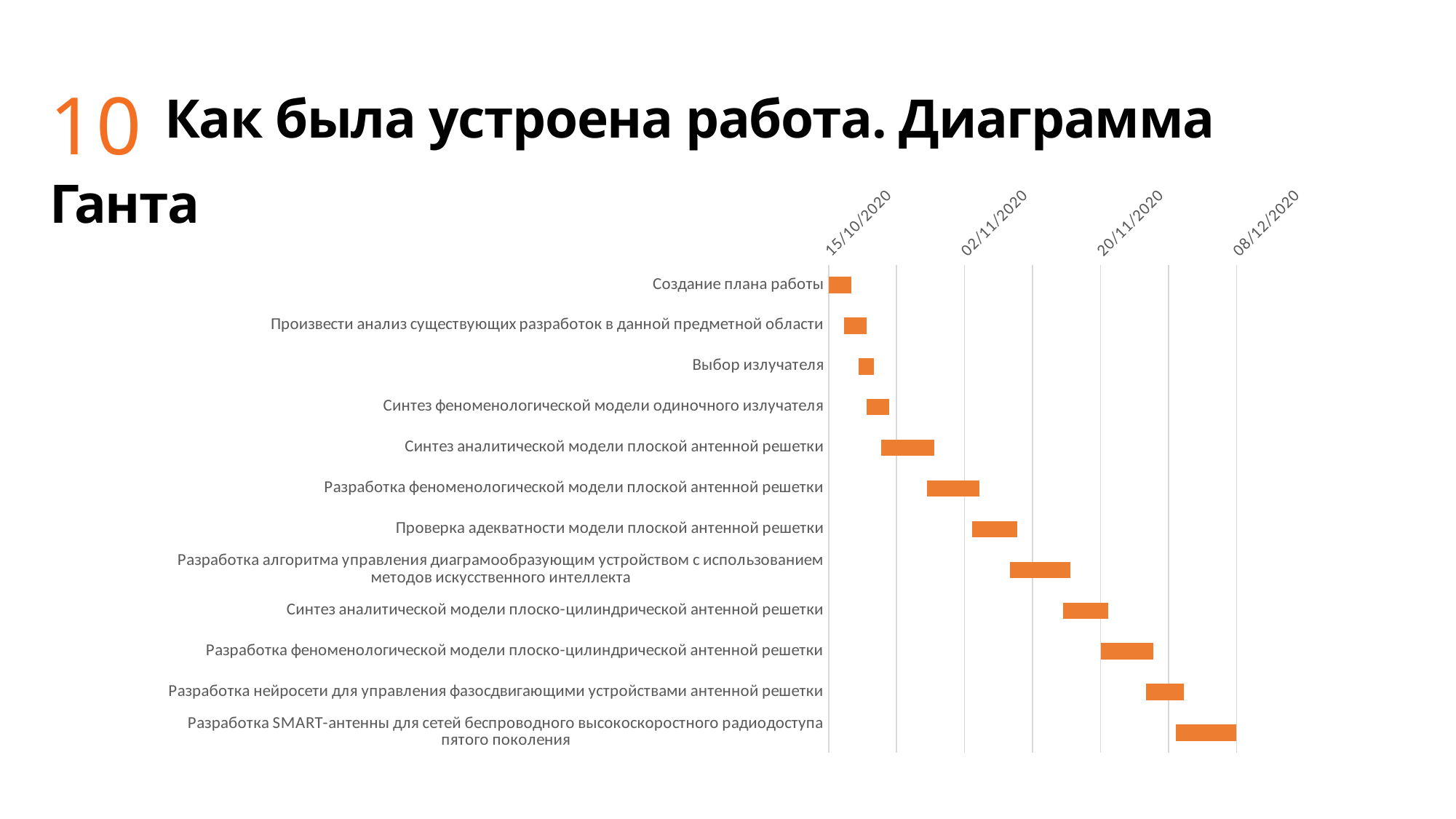
What kind of chart is shown on the slide? Bar chart (Gantt chart) How many date labels are shown on the horizontal axis? 4 Which task has the shortest bar in the Gantt chart? Выбор излучателя Which task's bar starts earliest on the timeline? Создание плана работы What is the earliest date label shown on the horizontal axis? 15/10/2020 Which task's bar ends latest on the timeline? Разработка SMART-антенны для сетей беспроводного высокоскоростного радиодоступа пятого поколения What is the latest date label shown on the horizontal axis? 08/12/2020 Which task is listed first (at the top) of the Gantt chart? Создание плана работы Does the bar for 'Разработка нейросети для управления фазосдвигающими устройствами антенной решетки' start before or after 20/11/2020? after Does the bar for 'Проверка адекватности модели плоской антенной решетки' start before or after 02/11/2020? after Which task starts later: 'Выбор излучателя' or 'Синтез аналитической модели плоской антенной решетки'? Синтез аналитической модели плоской антенной решетки How many tasks are listed on the vertical axis of the Gantt chart? 12